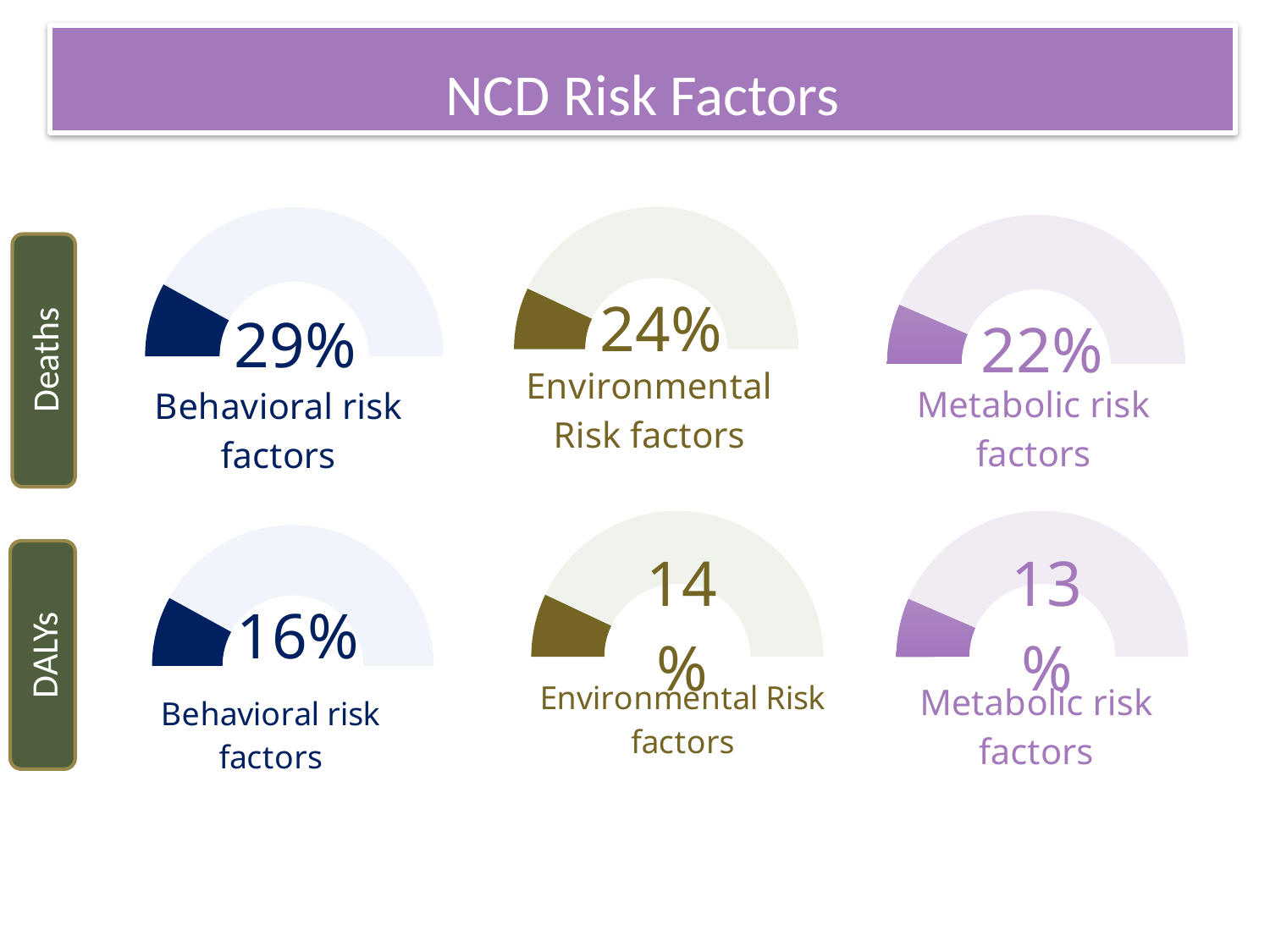
In the DALYs row, which risk factor group has the lowest percentage? Metabolic risk factors In the DALYs row, what percentage is shown for Behavioral risk factors? 16% In the Deaths row, what percentage is shown for Behavioral risk factors? 29% In the Deaths row, what percentage is shown for Metabolic risk factors? 22% In the Deaths row, what percentage is shown for Environmental Risk factors? 24% In the DALYs row, what percentage is shown for Metabolic risk factors? 13% What is the title of the slide containing these charts? NCD Risk Factors Which is larger: the DALYs percentage for Behavioral risk factors or the DALYs percentage for Environmental Risk factors? Behavioral risk factors In the Deaths row, which risk factor group has the highest percentage? Behavioral risk factors In the DALYs row, what percentage is shown for Environmental Risk factors? 14% What is the difference between the Deaths percentage for Behavioral risk factors and the Deaths percentage for Metabolic risk factors? 7% How many gauge charts are shown on the slide in total? 6